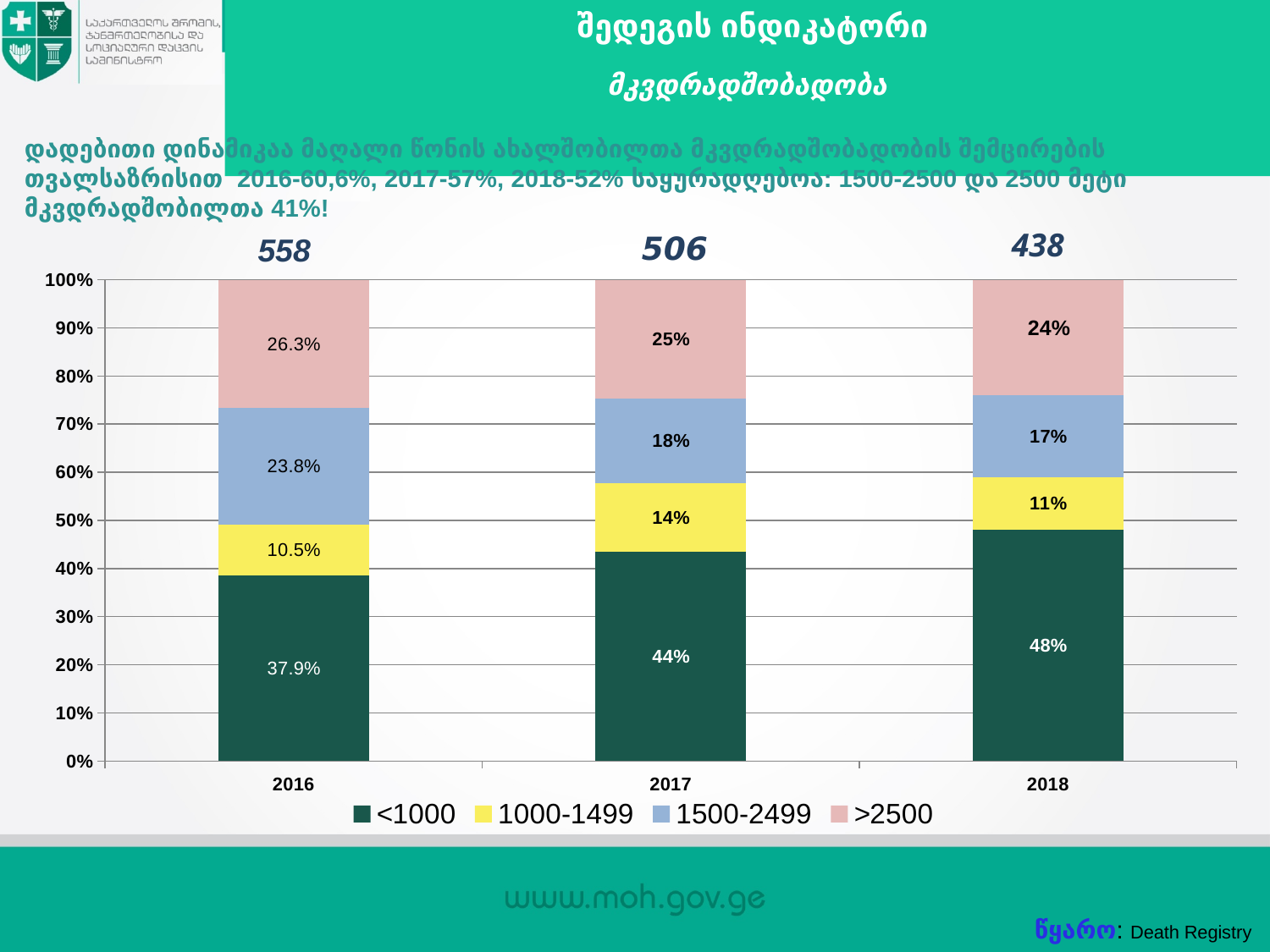
Which is larger, the 1000-1499 segment for 2017 or for 2018? 2017 What is the value of the >2500 segment for 2018? 24% What is the value of the 1500-2499 segment for 2017? 18% What number is printed above the 2017 bar? 506 What is the difference between the <1000 values for 2018 and 2017? 4% How many years are shown on the x axis? 3 What kind of chart is shown on the slide? stacked bar chart What is the value of the 1000-1499 segment for 2016? 10.5% What is the value of the <1000 segment for 2016? 37.9% Which year has the lowest value for the 1500-2499 segment? 2018 Which year has the highest value for the <1000 segment? 2018 How many series does the legend list? 4